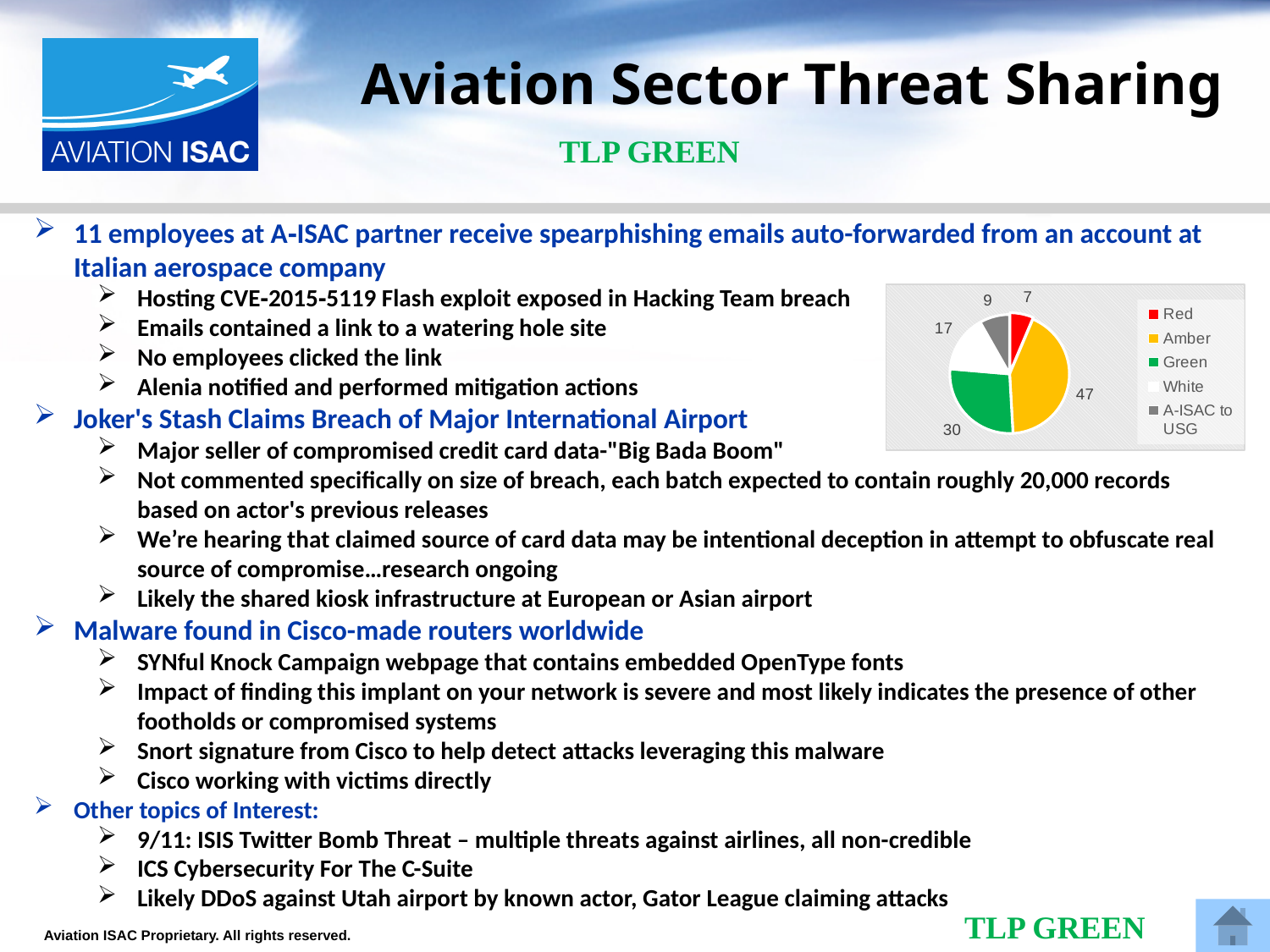
Which category has the largest slice in the pie chart? Amber What is the value of the Amber slice in the pie chart? 47 What is the difference between the Amber and Green values in the pie chart? 17 Which category has the smallest slice in the pie chart? Red How many categories does the pie chart's legend list? 5 What type of chart is shown on the slide? pie chart What is the value of the Red slice in the pie chart? 7 What is the total of all the slices in the pie chart? 110 Which is larger in the pie chart, the White slice or the A-ISAC to USG slice? White What is the value of the A-ISAC to USG slice in the pie chart? 9 What is the value of the Green slice in the pie chart? 30 What is the value of the White slice in the pie chart? 17